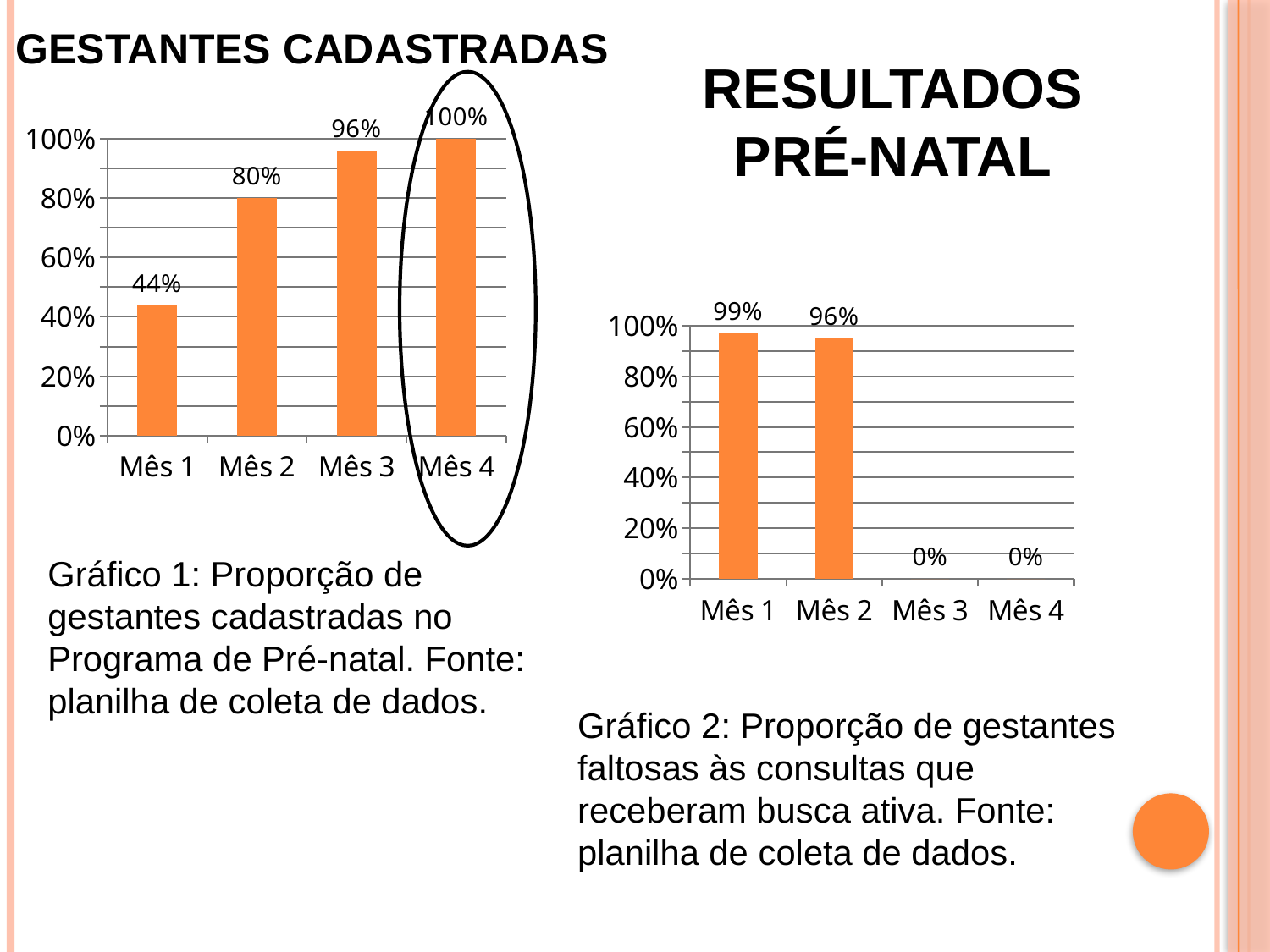
In Gráfico 2 (the chart on the right), what is the value for Mês 1? 99% In Gráfico 2 (the chart on the right), what is the value for Mês 3? 0% In Gráfico 1 (Gestantes Cadastradas), which month has the highest value? Mês 4 In Gráfico 1 (Gestantes Cadastradas), which month has the lowest value? Mês 1 In Gráfico 1 (Gestantes Cadastradas), what is the value for Mês 2? 80% In Gráfico 2 (the chart on the right), which is larger, Mês 1 or Mês 2? Mês 1 In Gráfico 1 (Gestantes Cadastradas), do the values rise or fall from Mês 1 to Mês 4? rise In Gráfico 2 (the chart on the right), what is the difference between Mês 1 and Mês 2? 3% What kind of chart is Gráfico 1 (Gestantes Cadastradas)? bar chart In Gráfico 1 (Gestantes Cadastradas), what is the difference between Mês 3 and Mês 1? 52% How many months are shown on the x axis of Gráfico 2 (the chart on the right)? 4 In Gráfico 1 (Gestantes Cadastradas), what is the value for Mês 1? 44%